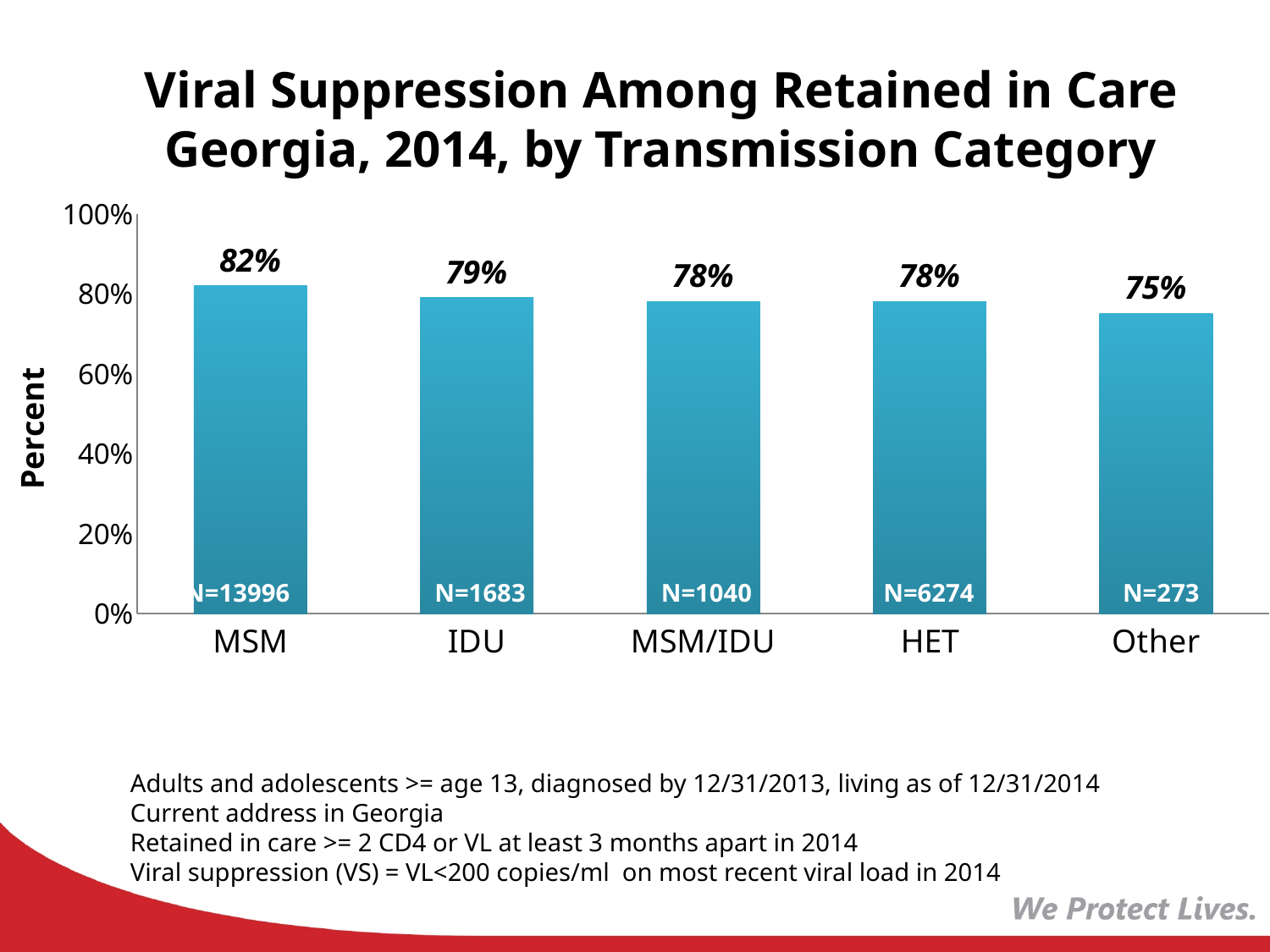
What is the viral suppression percentage for IDU? 79% What is the viral suppression percentage for the Other transmission category? 75% How many transmission categories are shown on the chart? 5 What is the N value shown on the HET bar? N=6274 Which has a higher viral suppression percentage, IDU or Other? IDU What is the label on the vertical axis of the chart? Percent Is the value for HET greater or less than 60%? greater What is the difference in viral suppression percentage between MSM and Other? 7% What is the viral suppression percentage for MSM? 82% Which transmission category has the lowest viral suppression percentage? Other What kind of chart is shown on the slide? Bar chart Which transmission category has the highest viral suppression percentage? MSM